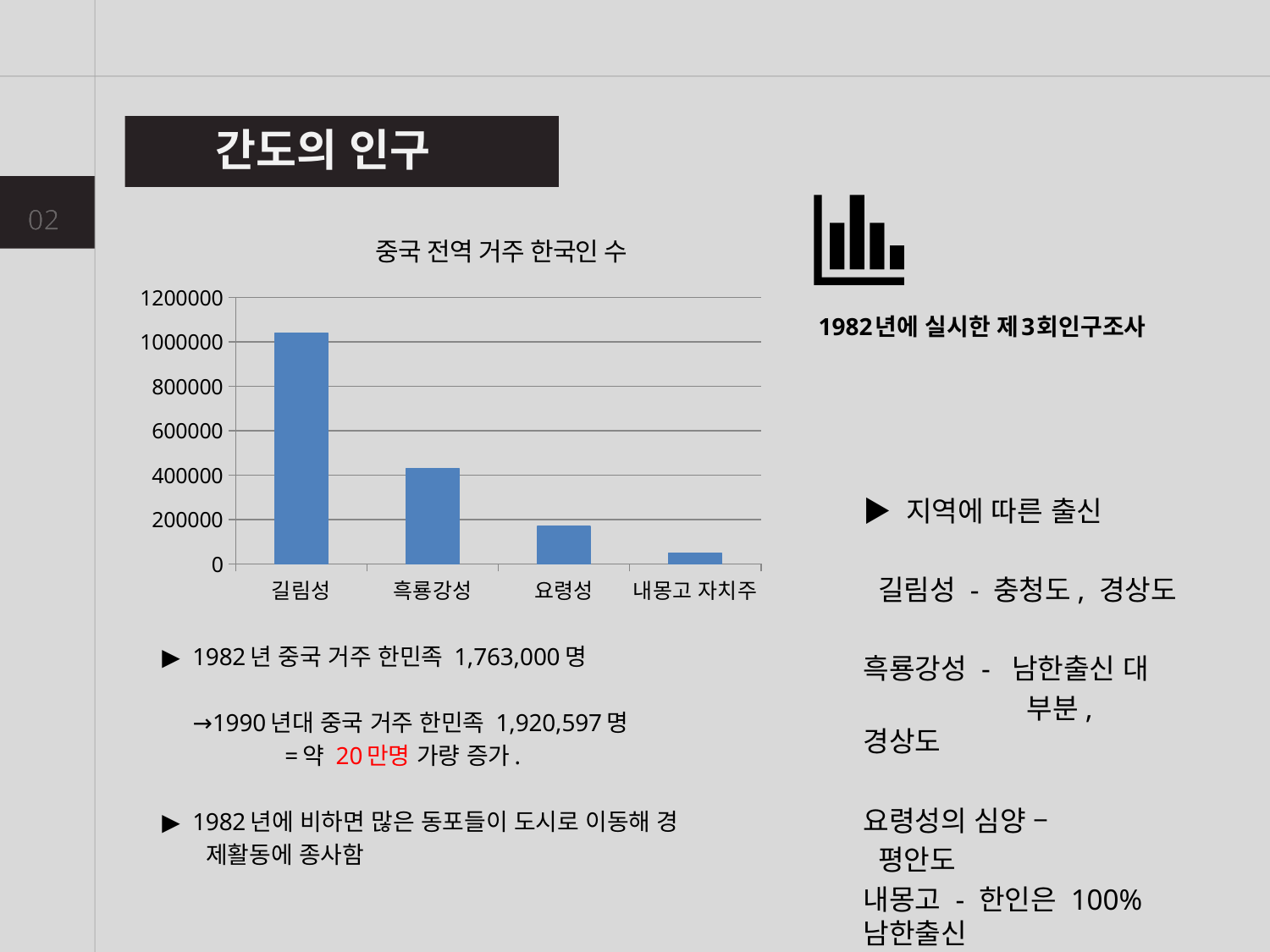
Which category has the highest value in the chart? 길림성 Which has a larger value, 요령성 or 내몽고 자치주? 요령성 Is the value for 흑룡강성 greater or less than 600000? less What is the title of the chart? 중국 전역 거주 한국인 수 What kind of chart is shown on the slide? bar chart Which has a larger value, 흑룡강성 or 요령성? 흑룡강성 How many categories are shown on the x axis of the chart? 4 Which category has the lowest value in the chart? 내몽고 자치주 What is the highest value shown on the y axis of the chart? 1200000 Is the value for 요령성 greater or less than 200000? less Do the values rise or fall from left to right along the x axis? fall Is the value for 길림성 greater or less than 800000? greater